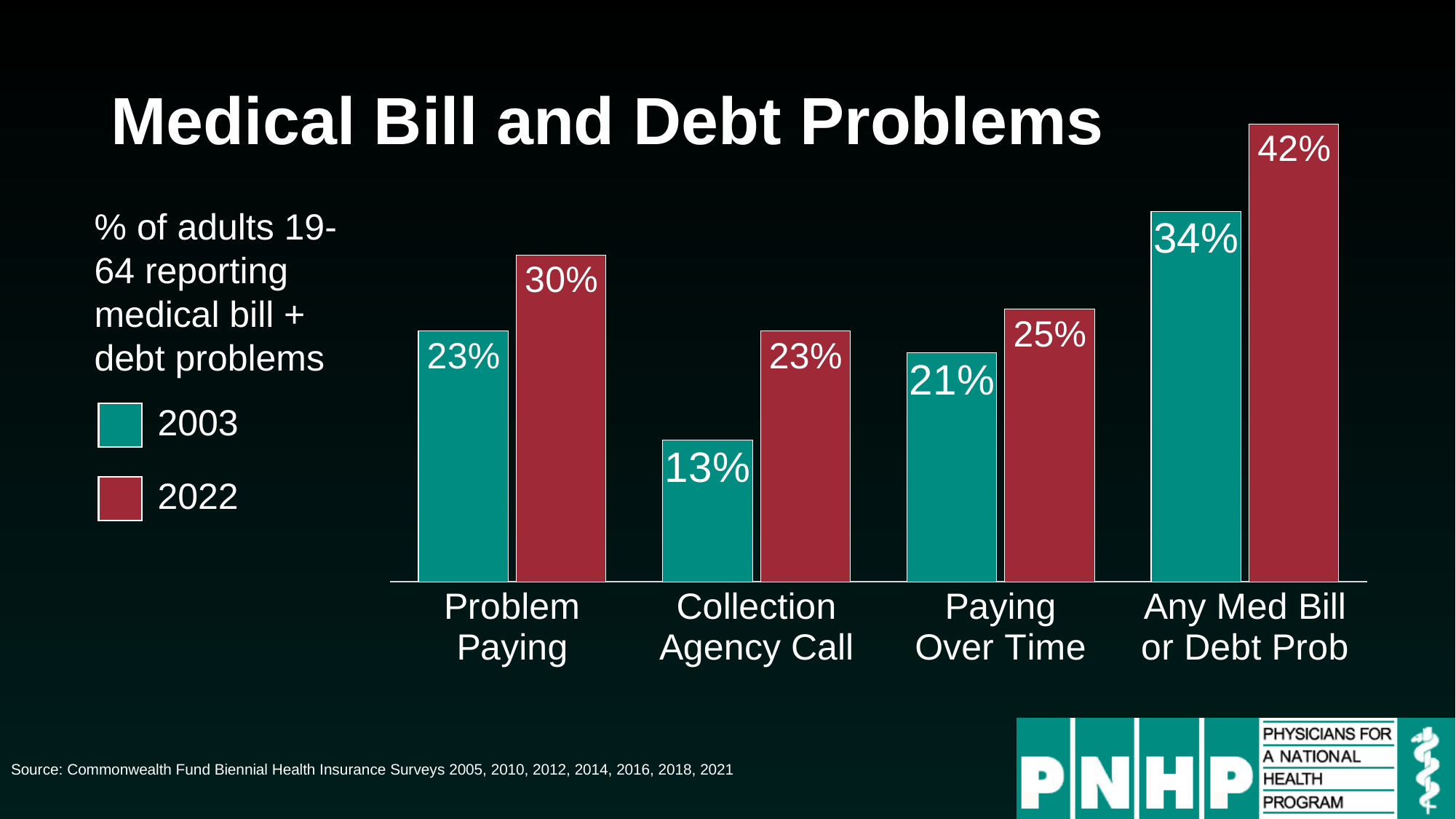
Which is larger for Problem Paying: the 2003 value or the 2022 value? 2022 What kind of chart is shown on the slide? Bar chart Which category has the highest 2022 value? Any Med Bill or Debt Prob How many series does the legend list? 2 Which category has the lowest 2003 value? Collection Agency Call What is the 2022 value for Paying Over Time? 25% What is the difference between the 2022 and 2003 values for Any Med Bill or Debt Prob? 8% What is the difference between the 2022 and 2003 values for Collection Agency Call? 10% What is the 2003 value for Problem Paying? 23% How many categories are shown on the x axis? 4 What is the 2022 value for Collection Agency Call? 23% What is the 2003 value for Any Med Bill or Debt Prob? 34%